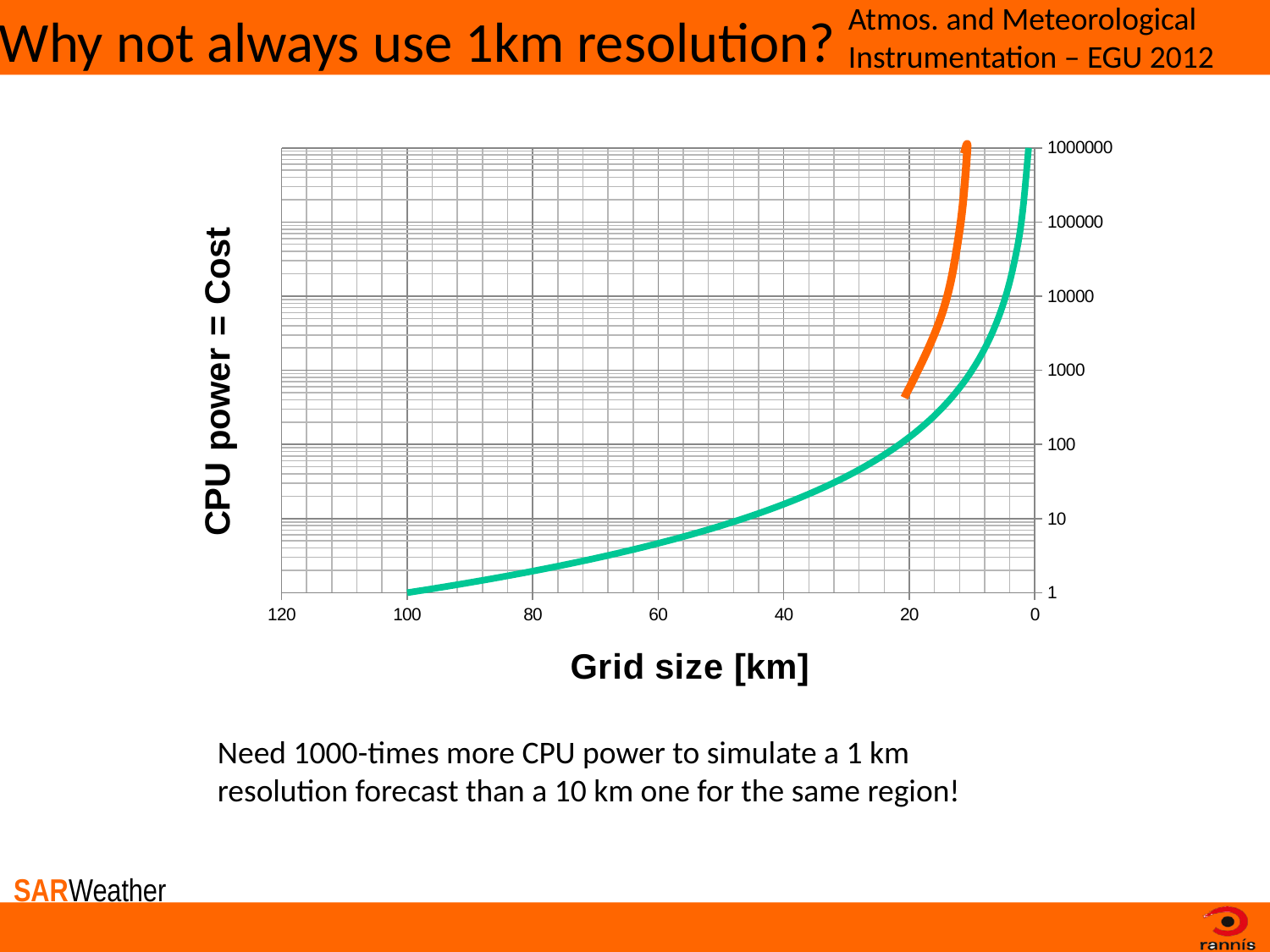
Moving from left to right along the x axis (from 120 km toward 0 km), do the plotted values rise or fall? rise Is the value of the green line at a grid size of 60 km greater or less than 10? less What is the title of the y axis of the chart? CPU power = Cost Is the value of the green line at a grid size of 80 km greater or less than 10? less What is the highest value labelled on the y axis? 1000000 What is the title of the x axis of the chart? Grid size [km] How many lines are plotted on the chart? 2 What kind of chart is shown on the slide? line chart At a grid size of 20 km, which line has the higher value, the orange line or the green line? orange line What is the value of the green line at a grid size of 100 km? 1 Is the value of the orange line at a grid size of 20 km greater or less than 100? greater